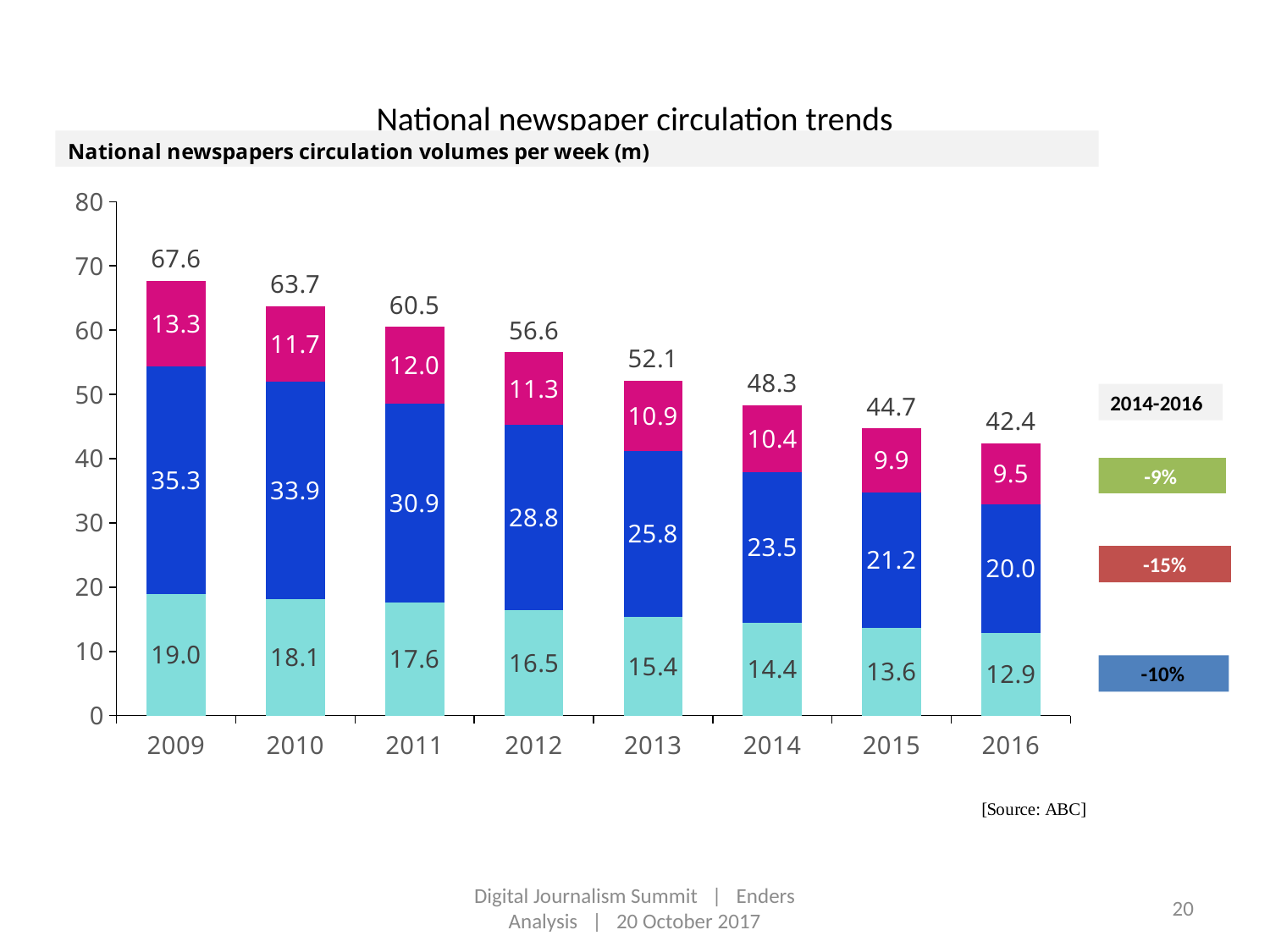
What is the value of the bottom (light blue) segment of the 2012 bar? 16.5 Which year has the larger middle (dark blue) segment, 2010 or 2011? 2010 Which year has the highest total circulation volume? 2009 How many years are shown on the x axis of the chart? 8 What is the total circulation volume shown for 2009? 67.6 What is the value of the top (magenta) segment of the 2014 bar? 10.4 Which year has the lowest total circulation volume? 2016 What is the difference between the total circulation volumes for 2009 and 2016? 25.2 Do the total circulation volumes rise or fall from 2009 to 2016? Fall What is the total circulation volume shown for 2016? 42.4 What kind of chart is used to show the circulation volumes? Stacked bar chart What is the difference between the total circulation volumes for 2013 and 2014? 3.8